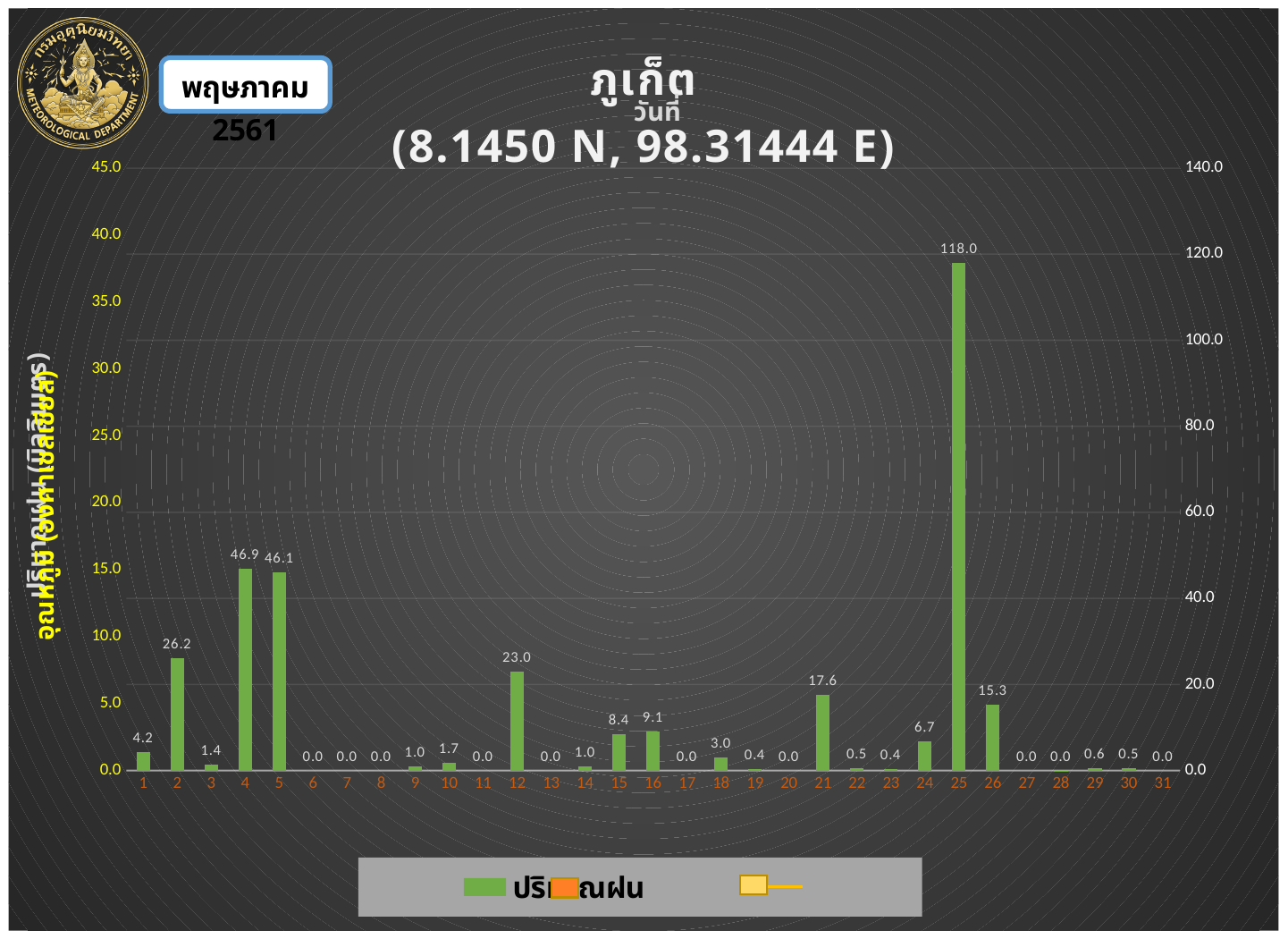
What is the value shown for day 4? 46.9 What is the value shown for day 21? 17.6 How many days are shown on the x axis? 31 What kind of chart is shown? bar chart What is the value shown for day 12? 23.0 Which is larger, the value for day 2 or the value for day 12? day 2 What coordinates are given in the chart title? 8.1450 N, 98.31444 E Which is larger, the value for day 15 or the value for day 16? day 16 What is the difference between the values for day 4 and day 5? 0.8 Which day has the highest value? 25 What is the difference between the values for day 25 and day 26? 102.7 What is the value shown for day 25? 118.0